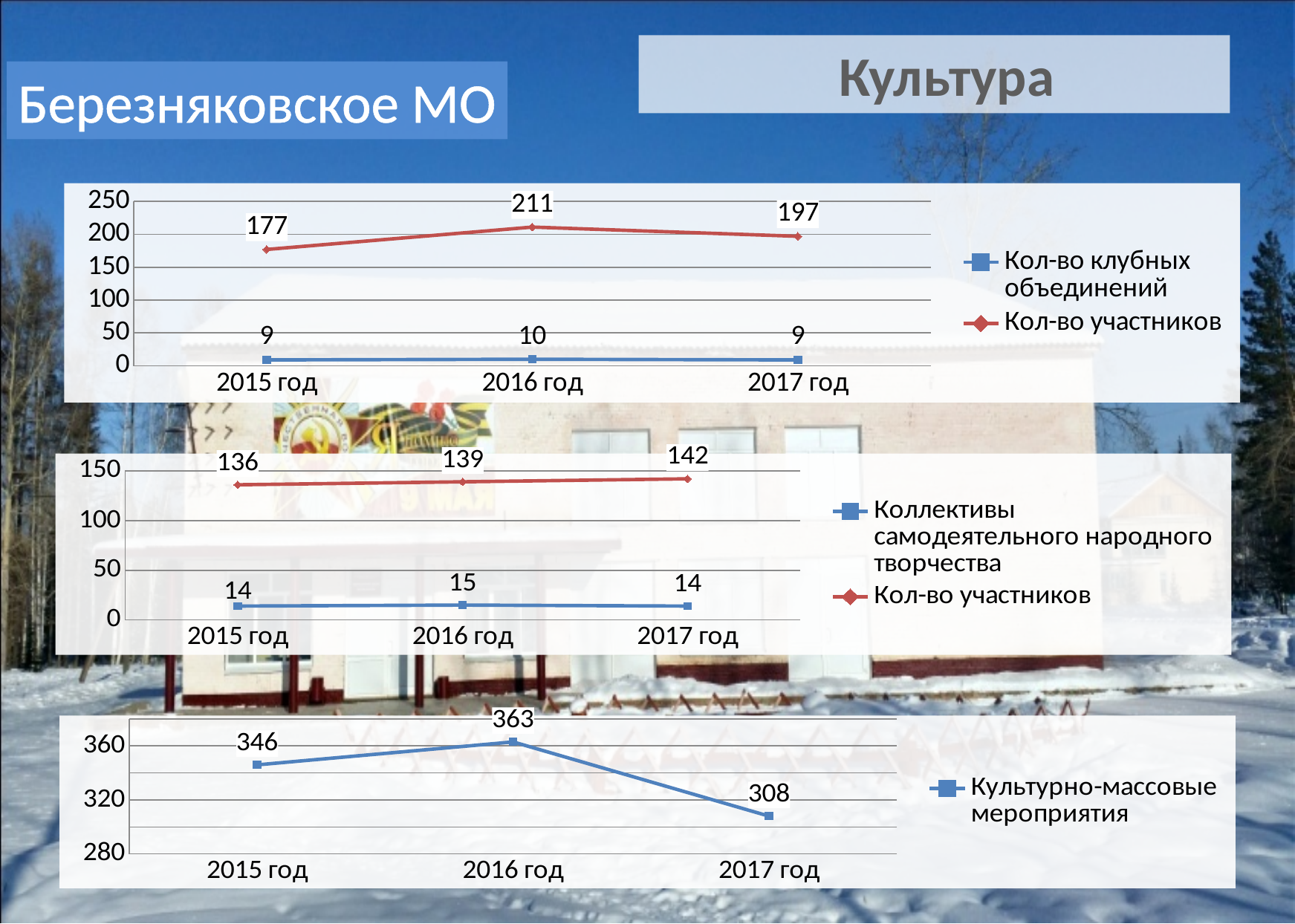
How many series does the legend of the top chart list? 2 In the top chart, what is the value of Кол-во клубных объединений for 2016 год? 10 In the top chart, what is the value of Кол-во участников for 2016 год? 211 In the top chart, what is the difference between Кол-во участников in 2016 год and 2015 год? 34 In the middle chart, does Кол-во участников rise or fall from 2015 год to 2017 год? rise In the top chart, in which year is Кол-во участников highest? 2016 год In the middle chart, in which year is Кол-во участников lowest? 2015 год In the middle chart, what is the value of Коллективы самодеятельного народного творчества for 2016 год? 15 In the bottom chart, what is the difference between the values for 2016 год and 2017 год? 55 In the bottom chart, what is the value of Культурно-массовые мероприятия for 2017 год? 308 What kind of chart is the bottom chart? line chart In the middle chart, what is the value of Кол-во участников for 2017 год? 142